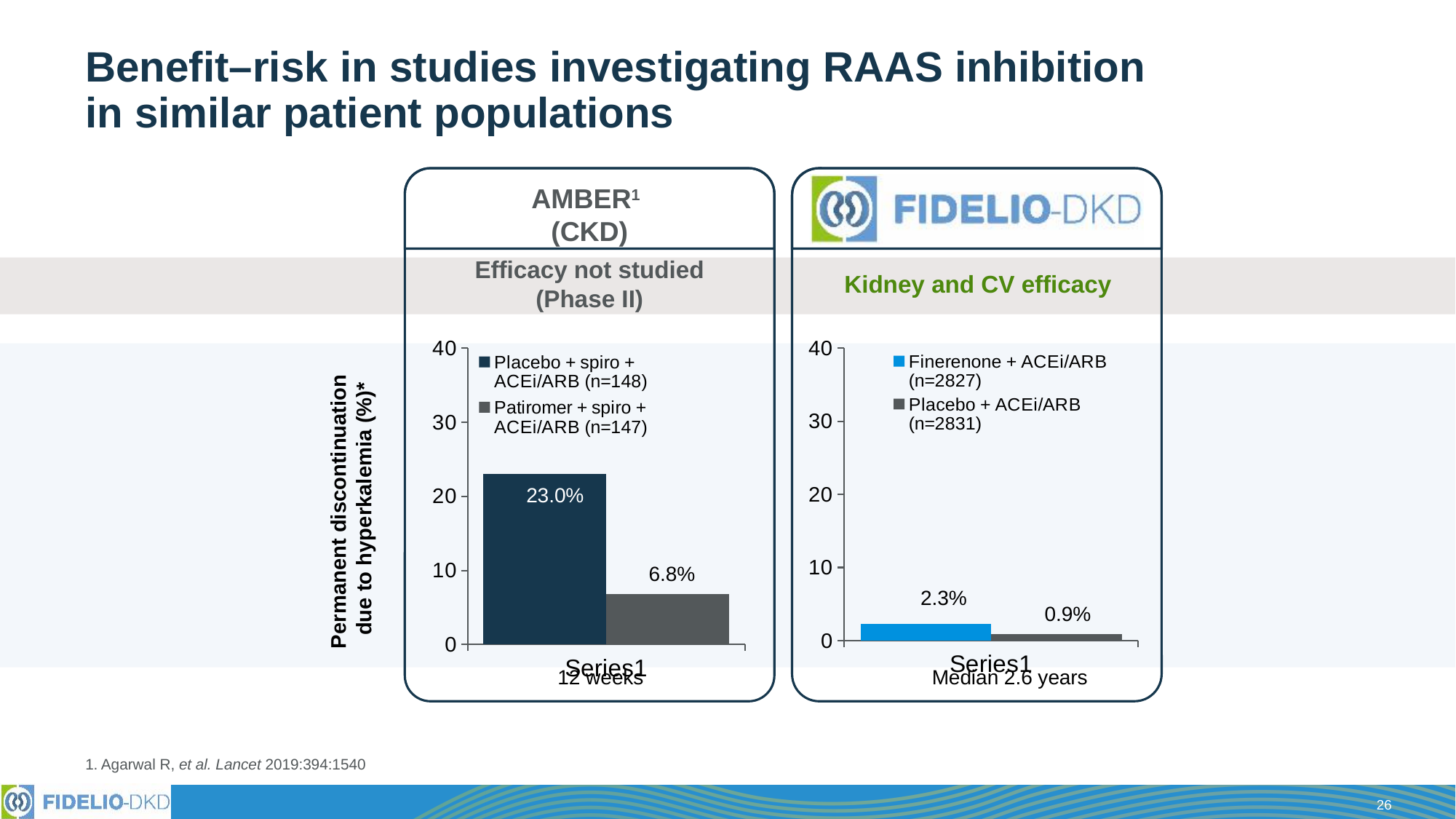
What kind of chart is the AMBER (CKD) chart? Bar chart In the FIDELIO-DKD chart, which series has the lower value? Placebo + ACEi/ARB (n=2831) In the FIDELIO-DKD chart, what is the value for Placebo + ACEi/ARB (n=2831)? 0.9% How many series does the legend of the FIDELIO-DKD chart list? 2 In the FIDELIO-DKD chart, what is the difference between the Finerenone + ACEi/ARB value and the Placebo + ACEi/ARB value? 1.4% In the FIDELIO-DKD chart, what is the value for Finerenone + ACEi/ARB (n=2827)? 2.3% What is the y-axis label shared by the two charts? Permanent discontinuation due to hyperkalemia (%)* In the AMBER (CKD) chart, what is the value for Placebo + spiro + ACEi/ARB (n=148)? 23.0% In the AMBER (CKD) chart, what is the difference between the Placebo + spiro + ACEi/ARB value and the Patiromer + spiro + ACEi/ARB value? 16.2% In the AMBER (CKD) chart, what is the value for Patiromer + spiro + ACEi/ARB (n=147)? 6.8% In the AMBER (CKD) chart, is the value for Placebo + spiro + ACEi/ARB greater or less than 20? greater In the AMBER (CKD) chart, which series has the higher value? Placebo + spiro + ACEi/ARB (n=148)